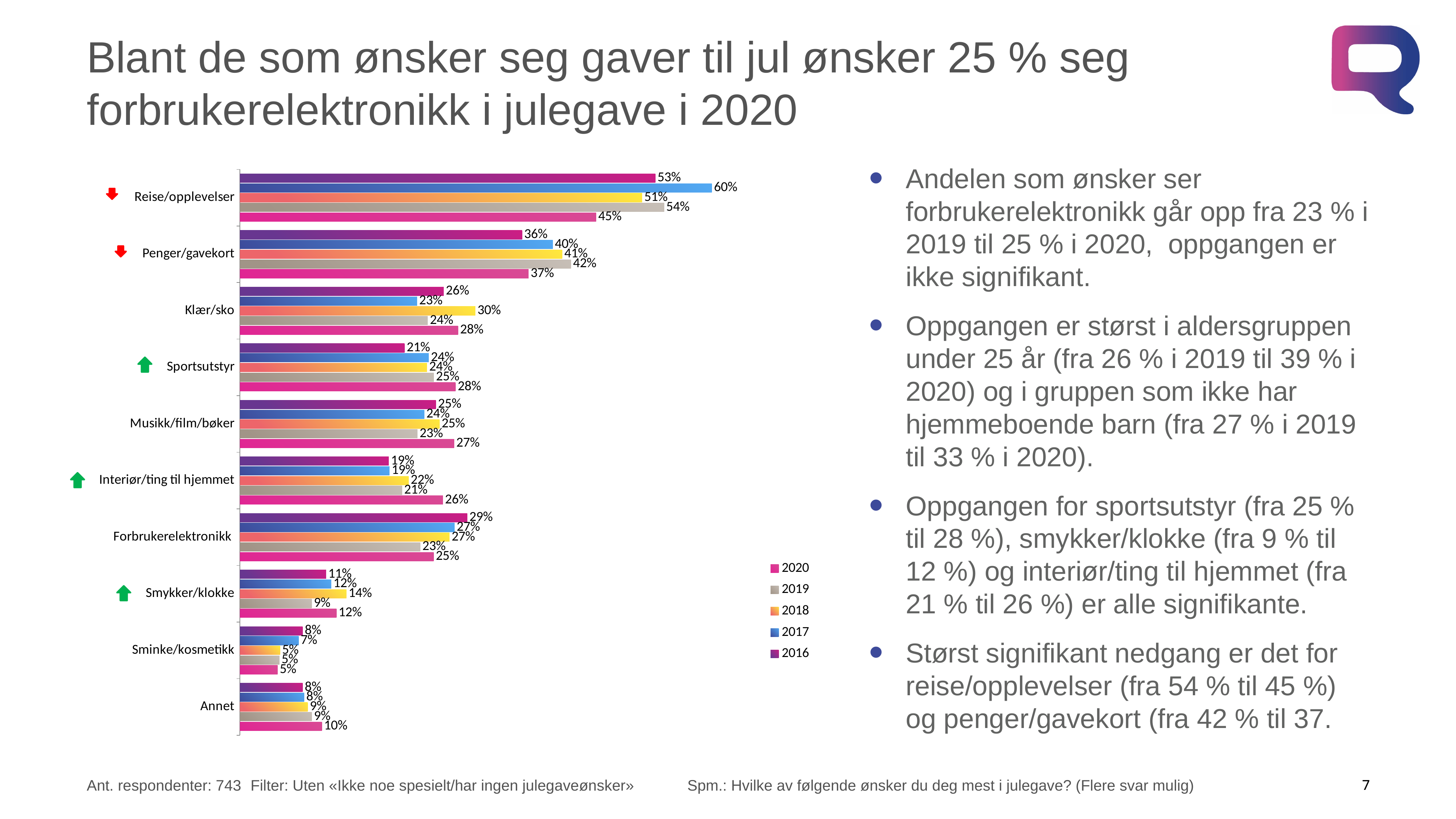
What kind of chart is shown on the slide? bar chart Which is larger for Klær/sko: the 2018 value or the 2019 value? 2018 What is the 2019 value for Forbrukerelektronikk? 23% What is the difference between the 2019 and 2020 values for Reise/opplevelser? 9% What is the difference between the 2020 and 2019 values for Interiør/ting til hjemmet? 5% Which legend entry is shown in grey? 2019 What is the 2017 value for Penger/gavekort? 40% What is the 2020 value for Reise/opplevelser? 45% Which category has the highest 2020 value? Reise/opplevelser How many series does the legend list? 5 How many categories are shown on the chart? 10 Which category has the lowest 2020 value? Sminke/kosmetikk